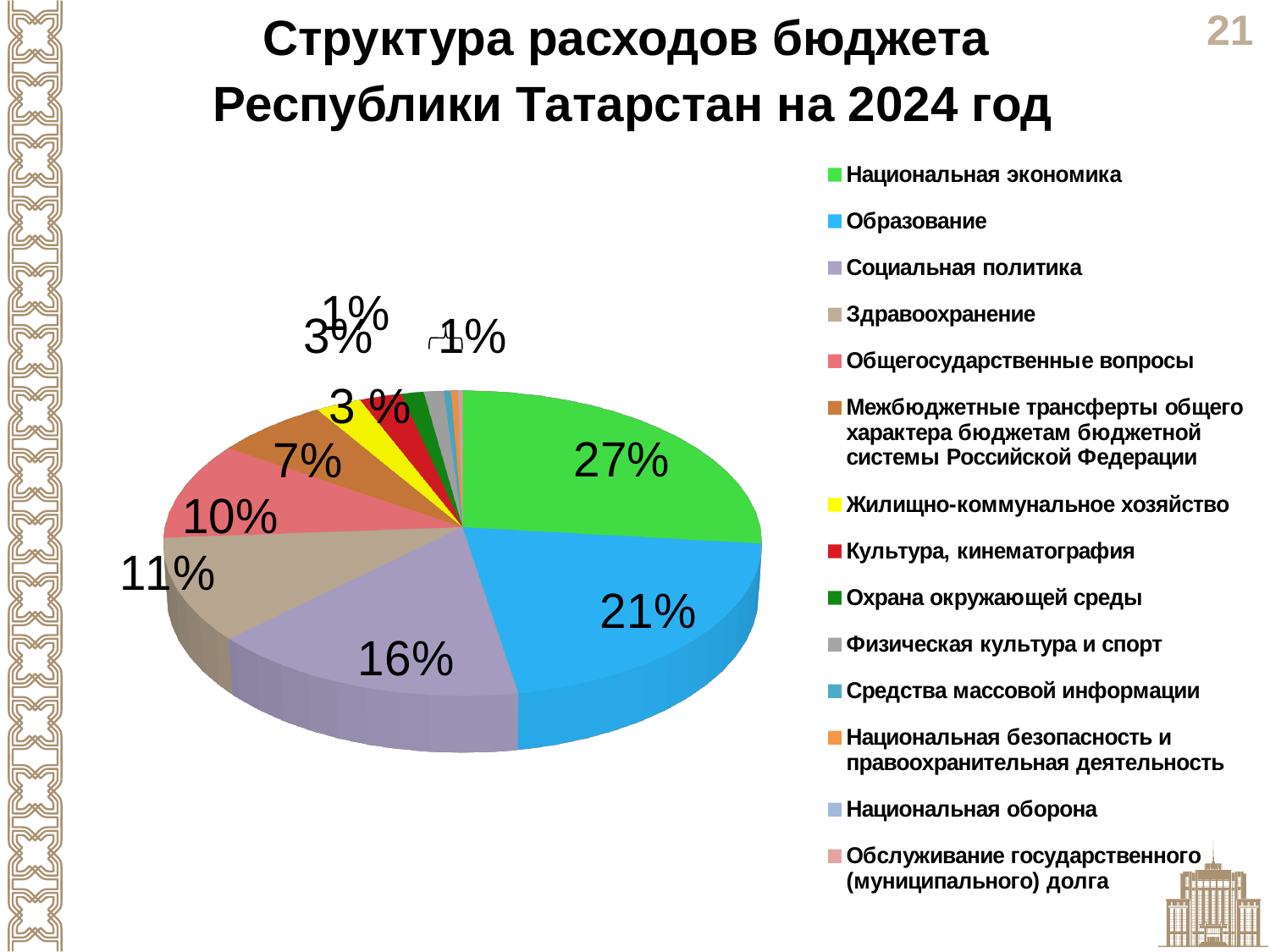
What share of the budget expenditure goes to Межбюджетные трансферты общего характера бюджетам бюджетной системы Российской Федерации? 7% What share of the budget expenditure goes to Образование? 21% What is the title of the slide? Структура расходов бюджета Республики Татарстан на 2024 год Which is larger, the share for Образование or the share for Социальная политика? Образование What share of the budget expenditure goes to Общегосударственные вопросы? 10% How many categories does the legend list? 14 What kind of chart is shown on the slide? pie chart What share of the budget expenditure goes to Здравоохранение? 11% What share of the budget expenditure goes to Национальная экономика? 27% What share of the budget expenditure goes to Социальная политика? 16% What is the difference between the share for Национальная экономика and the share for Образование? 6% Which category has the largest share of the budget expenditure? Национальная экономика